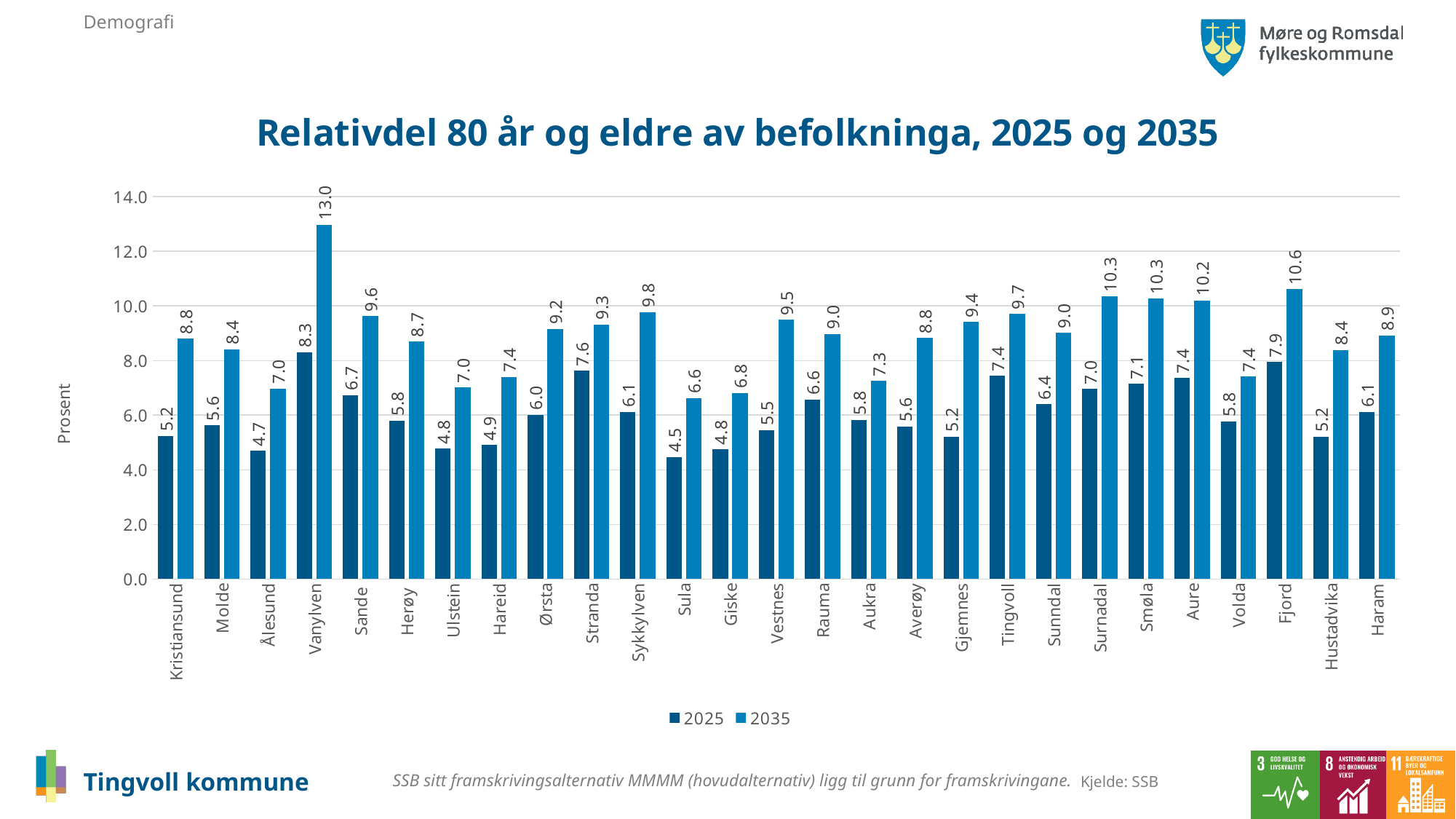
Which municipality has the highest 2035 value? Vanylven What is the difference between the 2035 and 2025 values for Gjemnes? 4.2 What is the 2035 value for Fjord? 10.6 What is the label on the y axis? Prosent What is the title of the chart? Relativdel 80 år og eldre av befolkninga, 2025 og 2035 Which is larger, the 2025 value for Stranda or the 2025 value for Rauma? Stranda What is the 2025 value for Vanylven? 8.3 What is the 2035 value for Tingvoll? 9.7 How many municipalities are shown on the x axis? 27 How many series does the legend list? 2 What kind of chart is this? Bar chart Which municipality has the lowest 2025 value? Sula